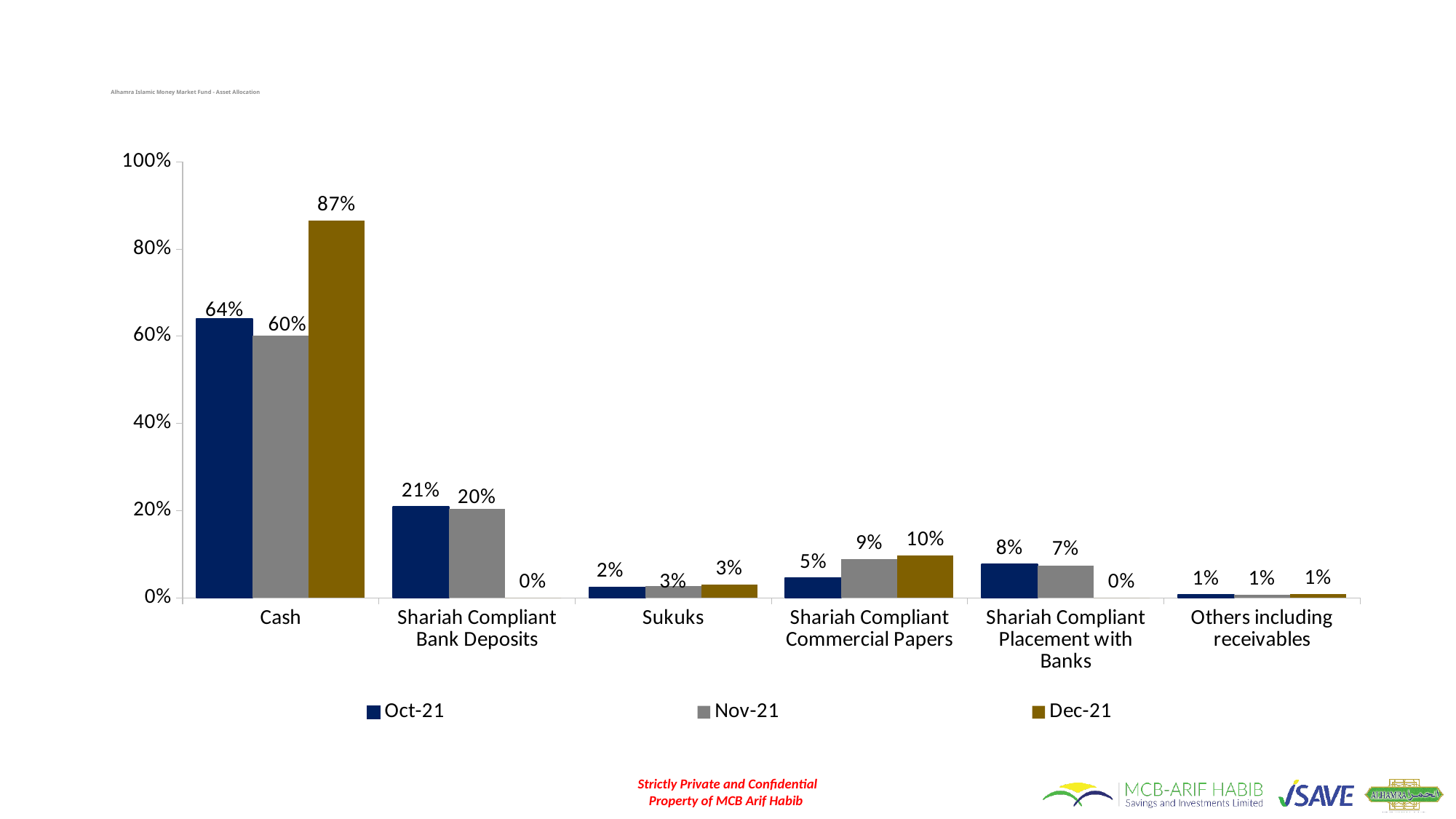
What kind of chart is shown on the slide? Bar chart Which series is shown in gold/brown in the legend? Dec-21 What is the Oct-21 value for Shariah Compliant Placement with Banks? 8% How many categories are shown on the x axis? 6 What is the difference between the Dec-21 and Oct-21 values for Cash? 23% Which category has the highest Dec-21 value? Cash Which category has the lowest Oct-21 value? Others including receivables What is the Nov-21 value for Shariah Compliant Bank Deposits? 20% How many series does the legend list? 3 Which is larger for Sukuks: the Oct-21 value or the Dec-21 value? Dec-21 What is the Dec-21 value for Cash? 87% What is the Dec-21 value for Shariah Compliant Commercial Papers? 10%